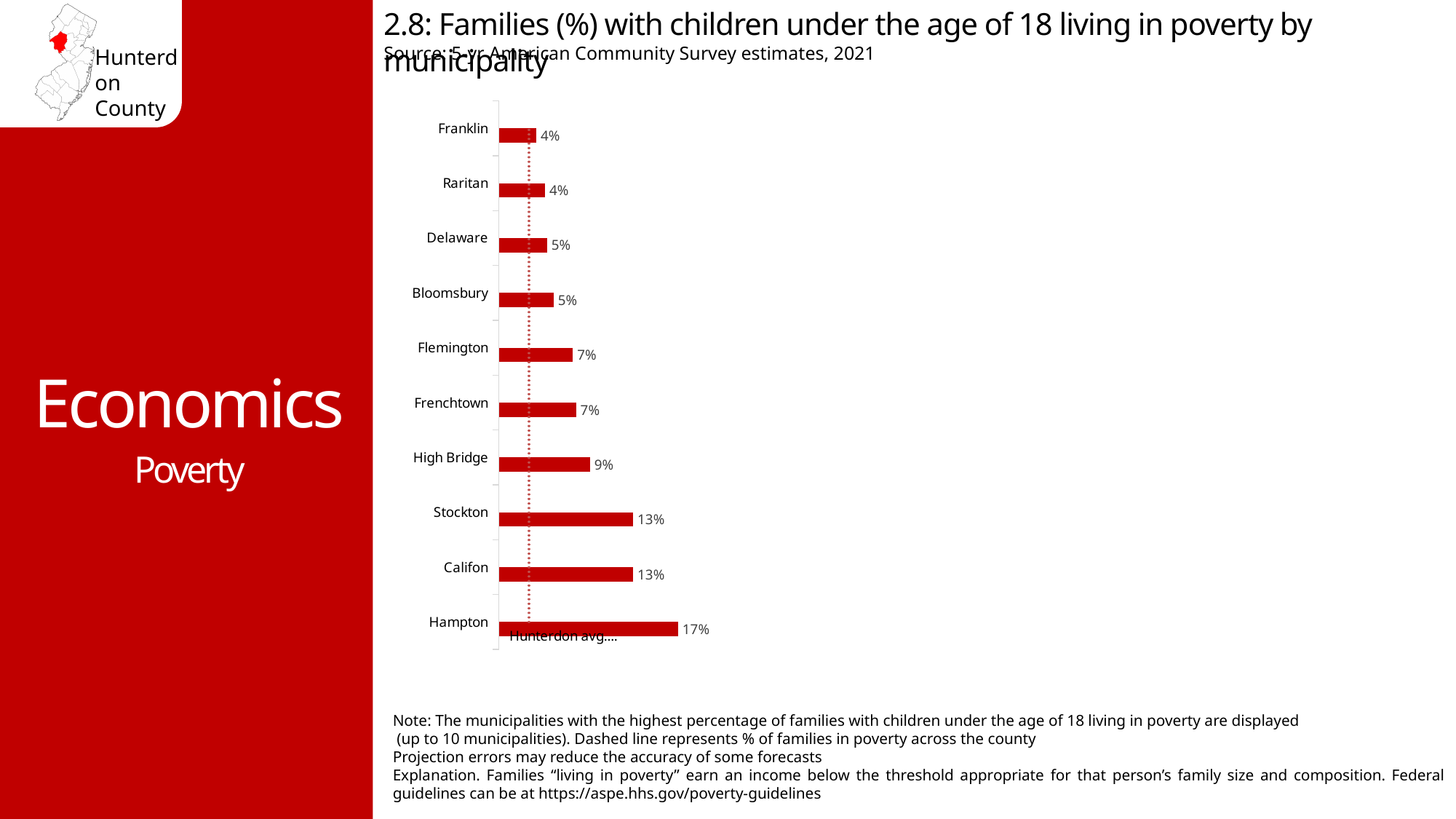
What is the difference between the values for High Bridge and Delaware? 4% What is the difference between the values for Hampton and Califon? 4% What is the value shown for High Bridge? 9% What is the value shown for Flemington? 7% Which has a larger value, Stockton or High Bridge? Stockton What kind of chart is shown on the slide? Bar chart Which municipality has the highest percentage of families with children under 18 living in poverty? Hampton What is the value shown for Stockton? 13% Which has a larger value, Frenchtown or Bloomsbury? Frenchtown What does the dashed vertical line in the chart represent? Hunterdon avg. (% of families in poverty across the county) What percentage of families with children under 18 are living in poverty in Hampton? 17% How many municipalities are shown in the chart? 10